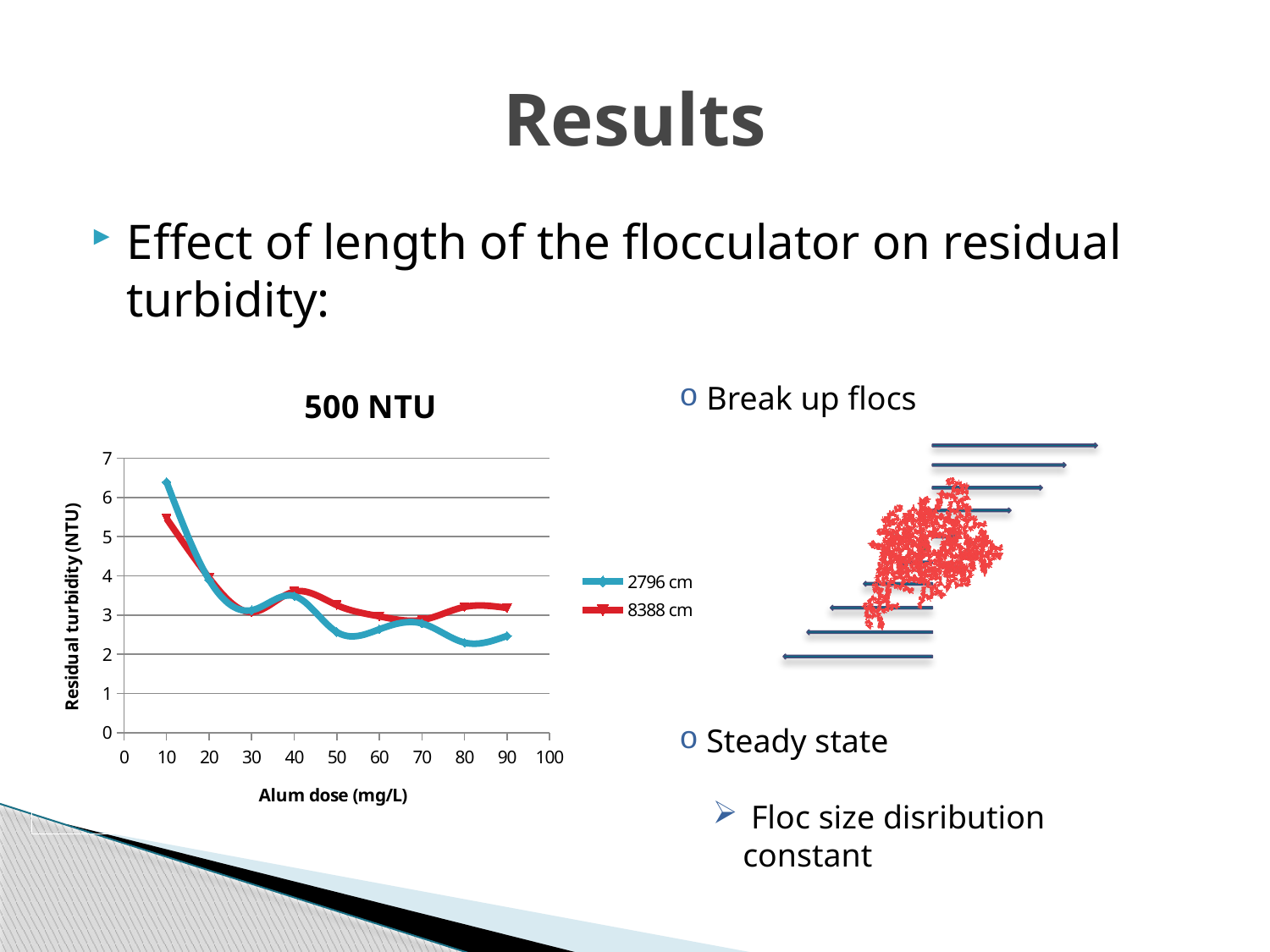
What kind of chart is shown on the slide? line chart At an alum dose of 10 mg/L, which series has the higher residual turbidity, 2796 cm or 8388 cm? 2796 cm Is the residual turbidity for the 8388 cm series at an alum dose of 10 mg/L greater or less than 6? less Overall, does residual turbidity rise or fall as the alum dose increases from 10 to 90 mg/L? fall Is the residual turbidity for the 2796 cm series at an alum dose of 90 mg/L greater or less than 3? less At an alum dose of 90 mg/L, which series has the higher residual turbidity, 2796 cm or 8388 cm? 8388 cm Is the residual turbidity for the 8388 cm series at an alum dose of 90 mg/L greater or less than 3? greater What is the label of the x axis of the chart? Alum dose (mg/L) How many series does the chart legend list? 2 What is the title of the chart? 500 NTU